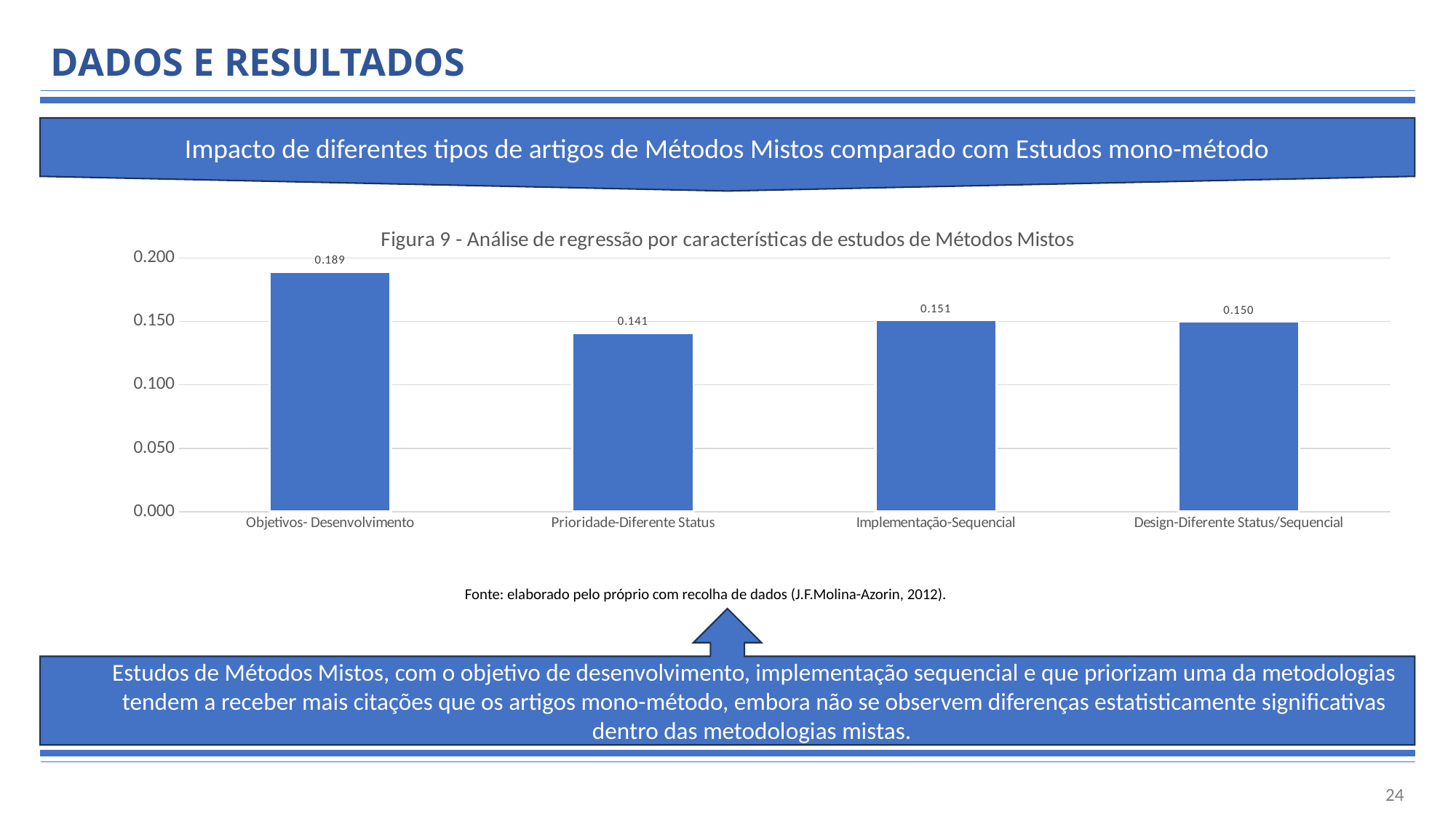
What is the value for Objetivos- Desenvolvimento? 0.189 What kind of chart is shown on the slide? Bar chart Which category has the highest value? Objetivos- Desenvolvimento Is the value for Prioridade-Diferente Status greater or less than 0.150? less What is the value for Implementação-Sequencial? 0.151 Which category has the lowest value? Prioridade-Diferente Status What is the title of the chart? Figura 9 - Análise de regressão por características de estudos de Métodos Mistos What is the value for Prioridade-Diferente Status? 0.141 What is the value for Design-Diferente Status/Sequencial? 0.150 Which is larger, the value for Objetivos- Desenvolvimento or the value for Implementação-Sequencial? Objetivos- Desenvolvimento What is the difference between the values for Objetivos- Desenvolvimento and Prioridade-Diferente Status? 0.048 How many categories are shown on the x axis? 4